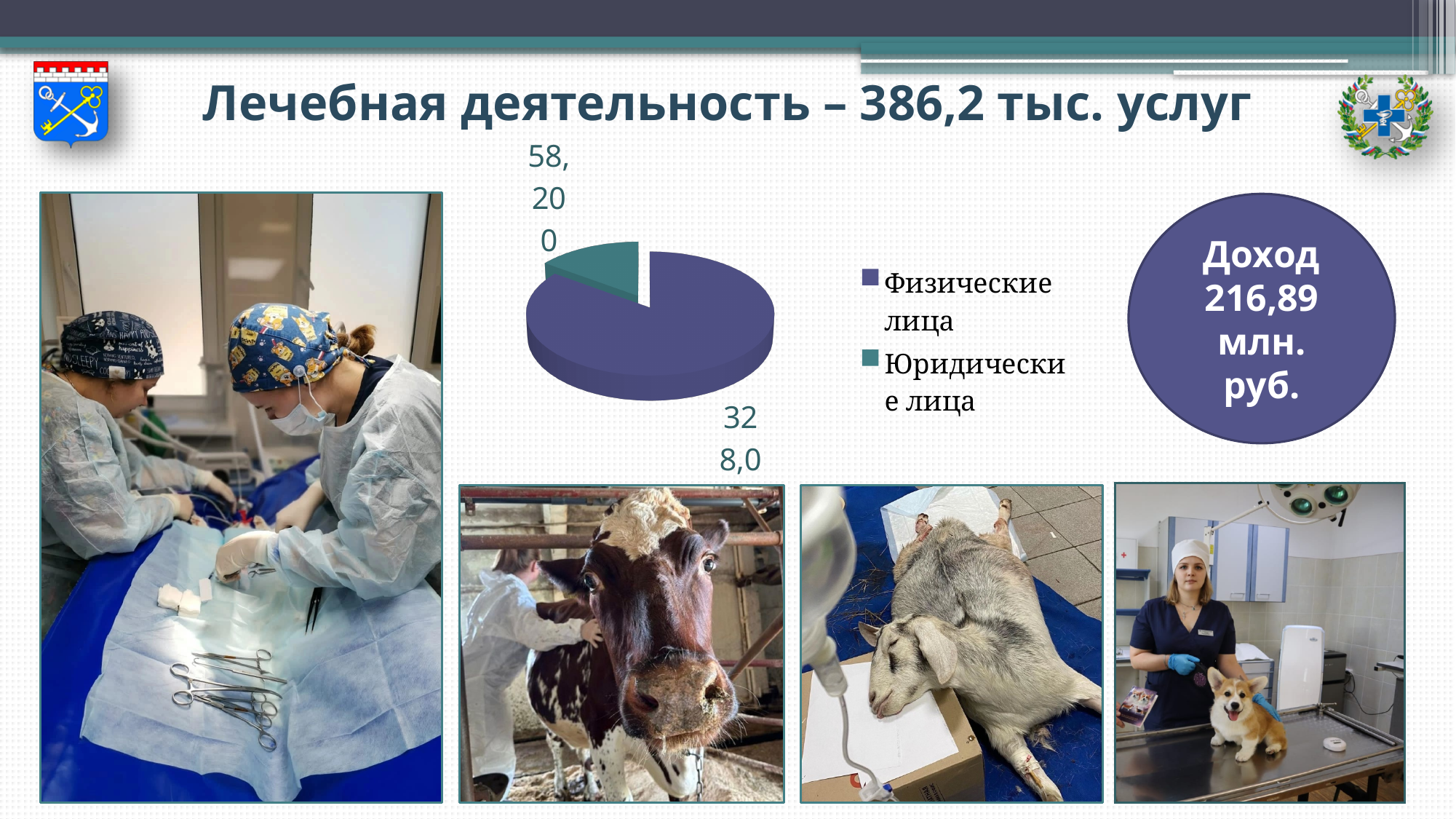
What kind of chart is shown on the slide? pie chart What is the title of the slide containing the pie chart? Лечебная деятельность – 386,2 тыс. услуг What colour is the slice for Юридические лица in the pie chart? teal Which is larger in the pie chart, Физические лица or Юридические лица? Физические лица How many entries does the legend of the pie chart list? 2 How many slices does the pie chart have? 2 What value is labelled on the pie slice for Юридические лица? 58,200 Which category has the largest slice in the pie chart? Физические лица What value is labelled on the pie slice for Физические лица? 328,0 Which category has the smallest slice in the pie chart? Юридические лица